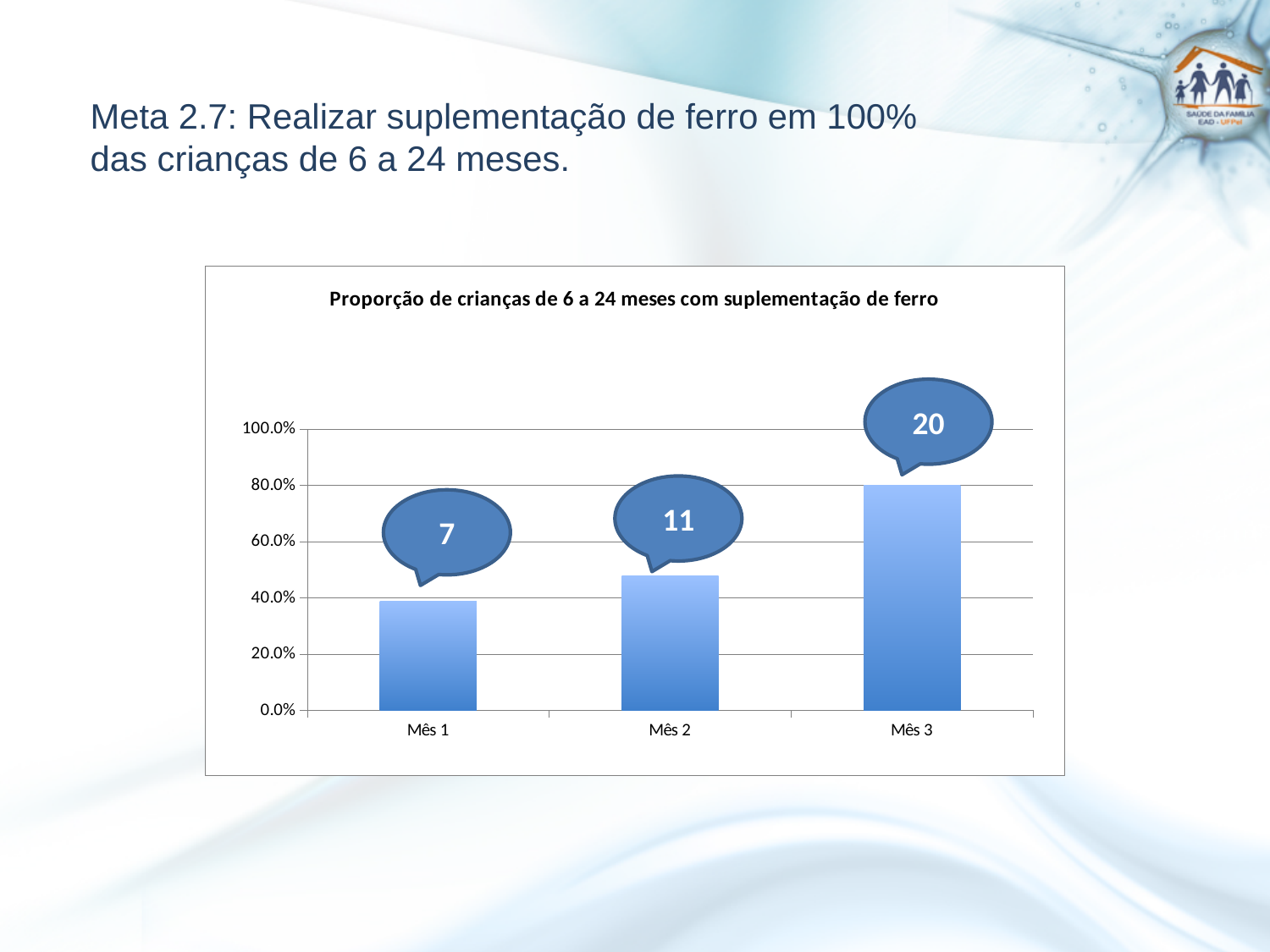
Is the value for Mês 2 greater or less than 40.0%? greater What is the title of the chart? Proporção de crianças de 6 a 24 meses com suplementação de ferro Which month has the highest proportion in the chart? Mês 3 What is the proportion for Mês 3? 80.0% Do the values rise or fall from Mês 1 to Mês 3? rise What kind of chart is shown on the slide? bar chart Which is larger, the value for Mês 1 or the value for Mês 2? Mês 2 Which month has the lowest proportion in the chart? Mês 1 What number is shown in the callout above the Mês 2 bar? 11 Is the value for Mês 2 greater or less than 60.0%? less How many categories are shown on the x axis of the chart? 3